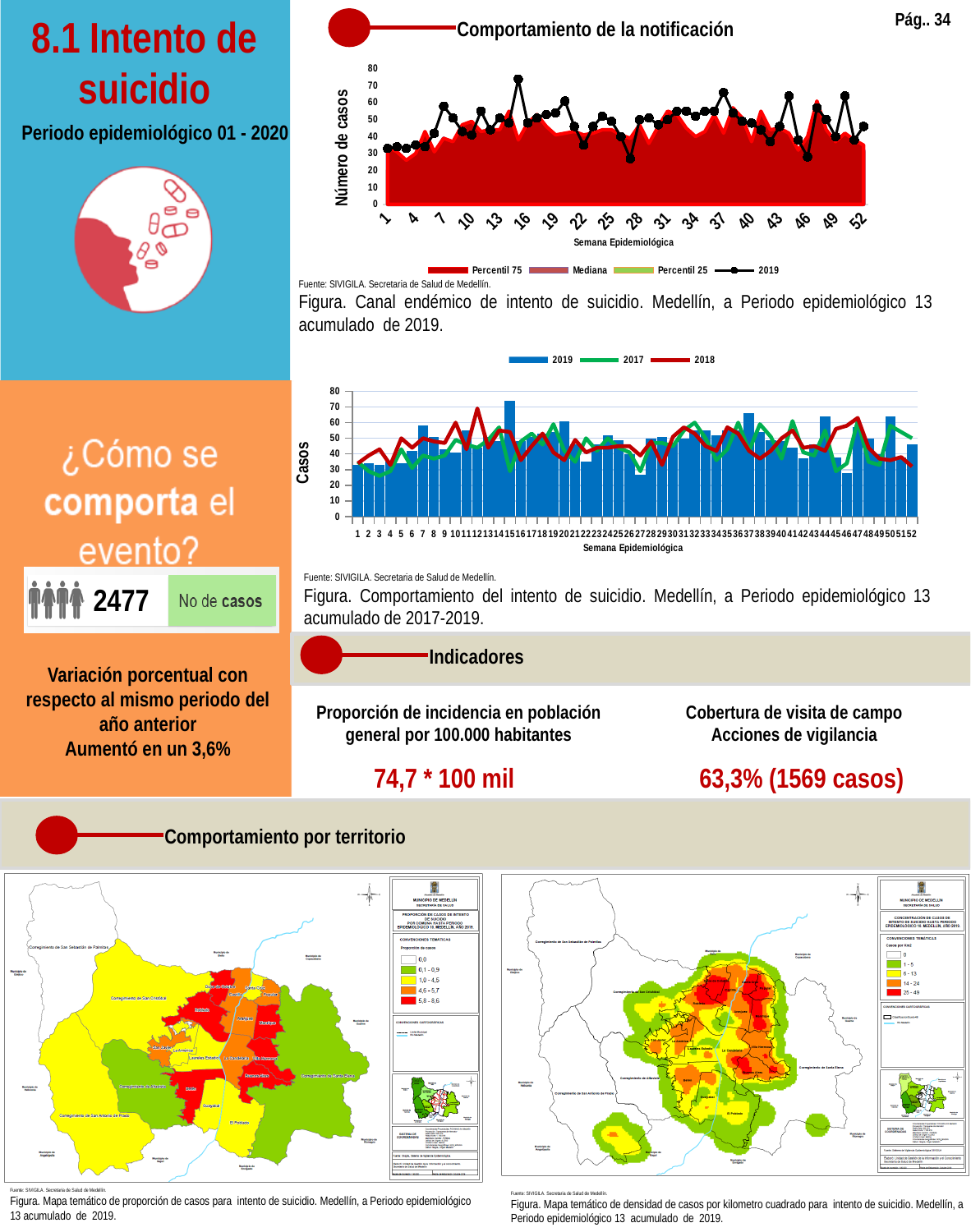
In the second chart (Comportamiento del intento de suicidio, 2017-2019), what is the label of the x axis? Semana Epidemiológica In the chart titled 'Comportamiento de la notificación', is the 2019 value at week 15 greater or less than 60? greater In the second chart (Comportamiento del intento de suicidio, 2017-2019), what kind of chart is used to show the 2019 series? bar chart In the second chart (Comportamiento del intento de suicidio, 2017-2019), is the 2019 value at week 7 greater or less than 50? greater In the second chart (Comportamiento del intento de suicidio, 2017-2019), is the 2019 value at week 46 greater or less than 40? less In the chart titled 'Comportamiento de la notificación', how many series does the legend list? 4 In the chart titled 'Comportamiento de la notificación', how many epidemiological weeks are shown on the x axis? 52 In the second chart (Comportamiento del intento de suicidio, 2017-2019), how many series does the legend list? 3 In the chart titled 'Comportamiento de la notificación', what is the label of the y axis? Número de casos